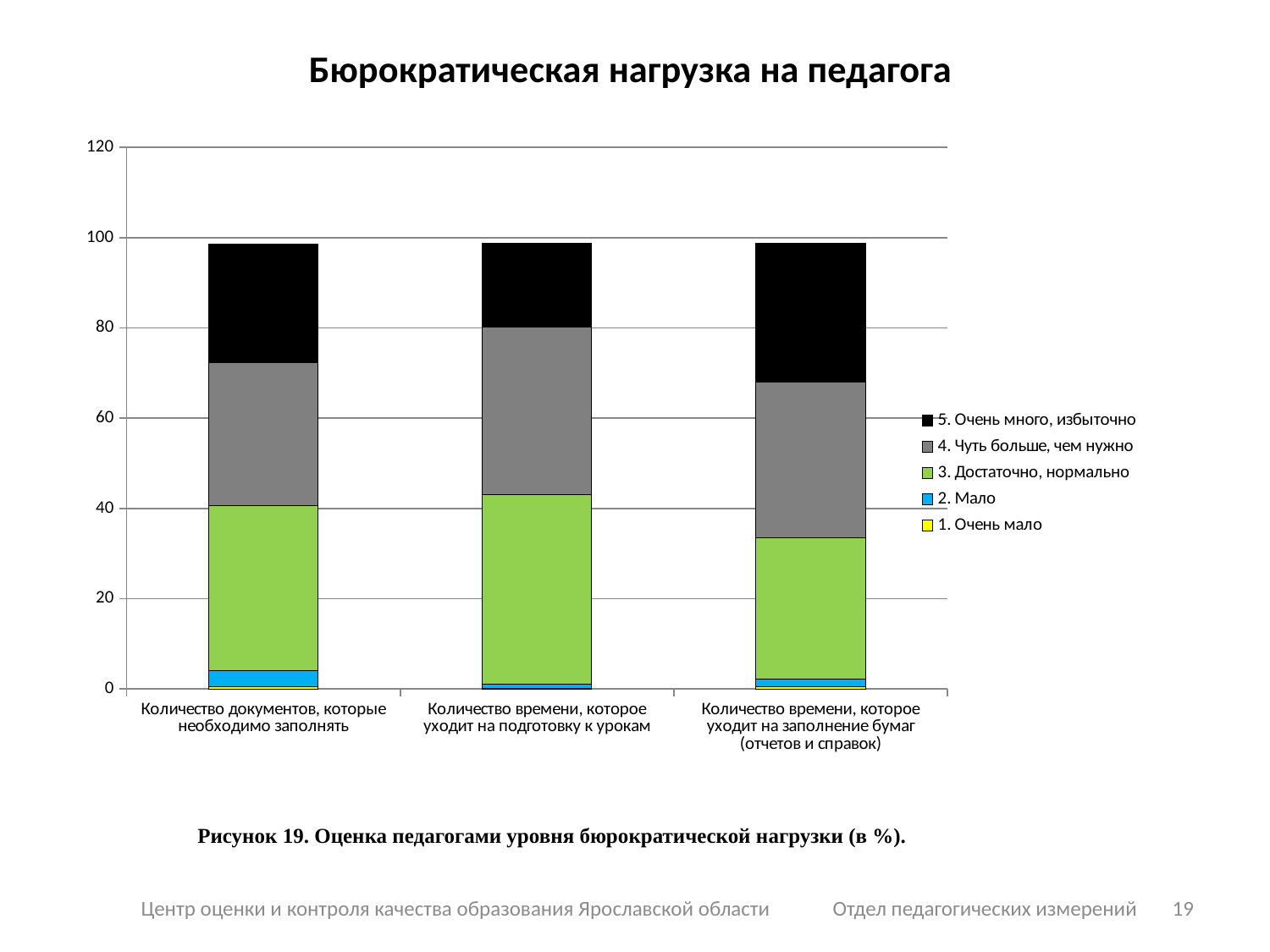
Is the total height of the stacked bar for "Количество документов, которые необходимо заполнять" greater or less than 80? greater Is the "5. Очень много, избыточно" segment larger for "Количество времени, которое уходит на подготовку к урокам" or for "Количество времени, которое уходит на заполнение бумаг (отчетов и справок)"? Количество времени, которое уходит на заполнение бумаг (отчетов и справок) What is the title of the chart? Бюрократическая нагрузка на педагога What kind of chart is shown on the slide? Stacked bar chart Which legend entry is shown in black? 5. Очень много, избыточно Which category has the smallest "3. Достаточно, нормально" segment? Количество времени, которое уходит на заполнение бумаг (отчетов и справок) Is the top of the "4. Чуть больше, чем нужно" segment for "Количество времени, которое уходит на заполнение бумаг (отчетов и справок)" greater or less than 80? less How many categories are shown on the x axis of the chart? 3 Is the top of the "3. Достаточно, нормально" segment for "Количество времени, которое уходит на подготовку к урокам" greater or less than 40? greater Which category has the largest "2. Мало" segment? Количество документов, которые необходимо заполнять How many series does the legend list? 5